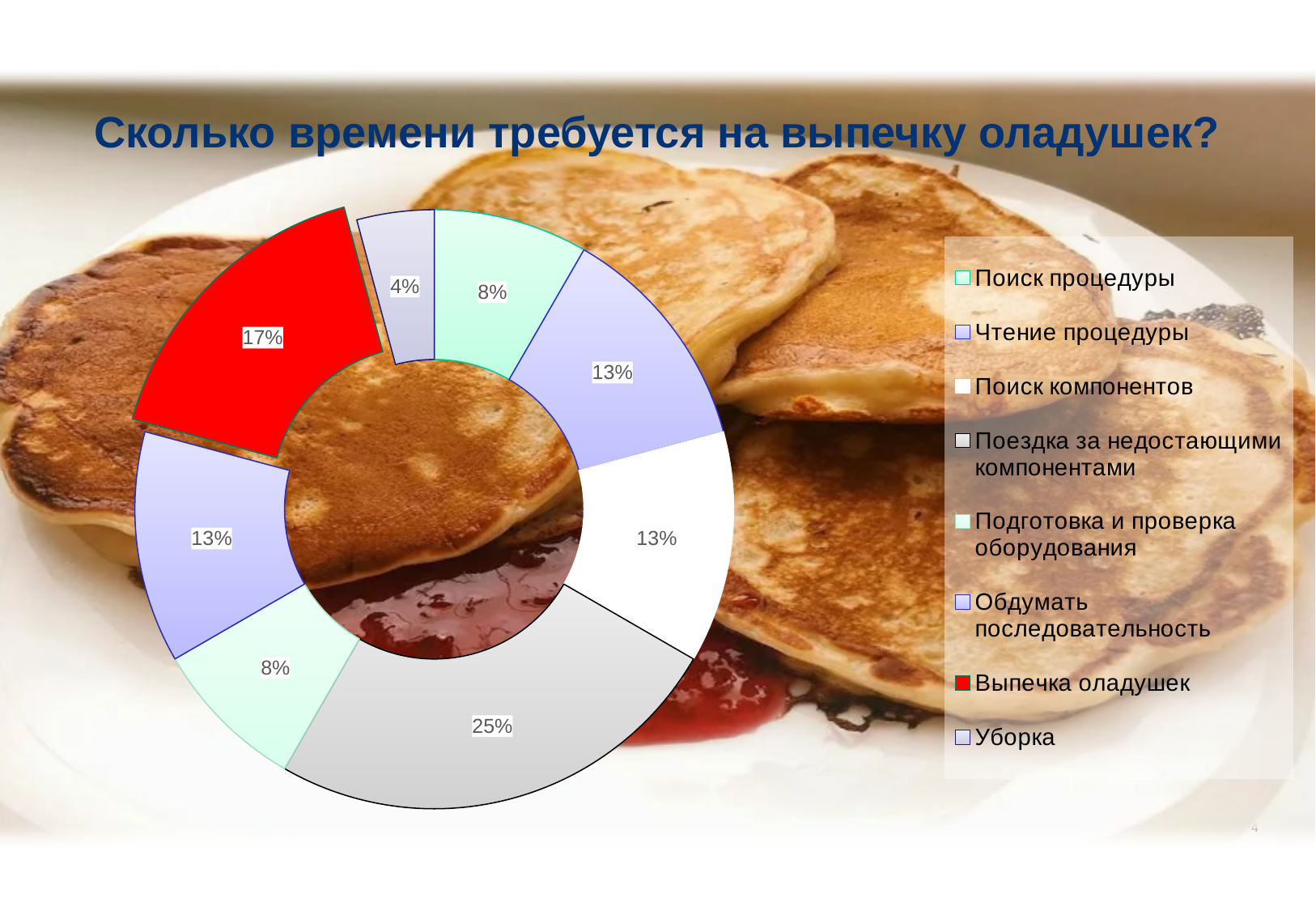
Which category has the largest share of the chart? Поездка за недостающими компонентами What share of time does Поездка за недостающими компонентами take? 25% Which has a larger share: Выпечка оладушек or Поиск компонентов? Выпечка оладушек How many entries does the legend list? 8 Which category has the smallest share of the chart? Уборка How many slices does the doughnut chart have? 8 What share of time does Уборка take? 4% What kind of chart is shown on the slide? Doughnut (pie) chart What share of time does Выпечка оладушек take? 17% What is the title of the chart on the slide? Сколько времени требуется на выпечку оладушек? What is the difference in percentage points between Поездка за недостающими компонентами and Выпечка оладушек? 8% What share of time does Поиск компонентов take? 13%